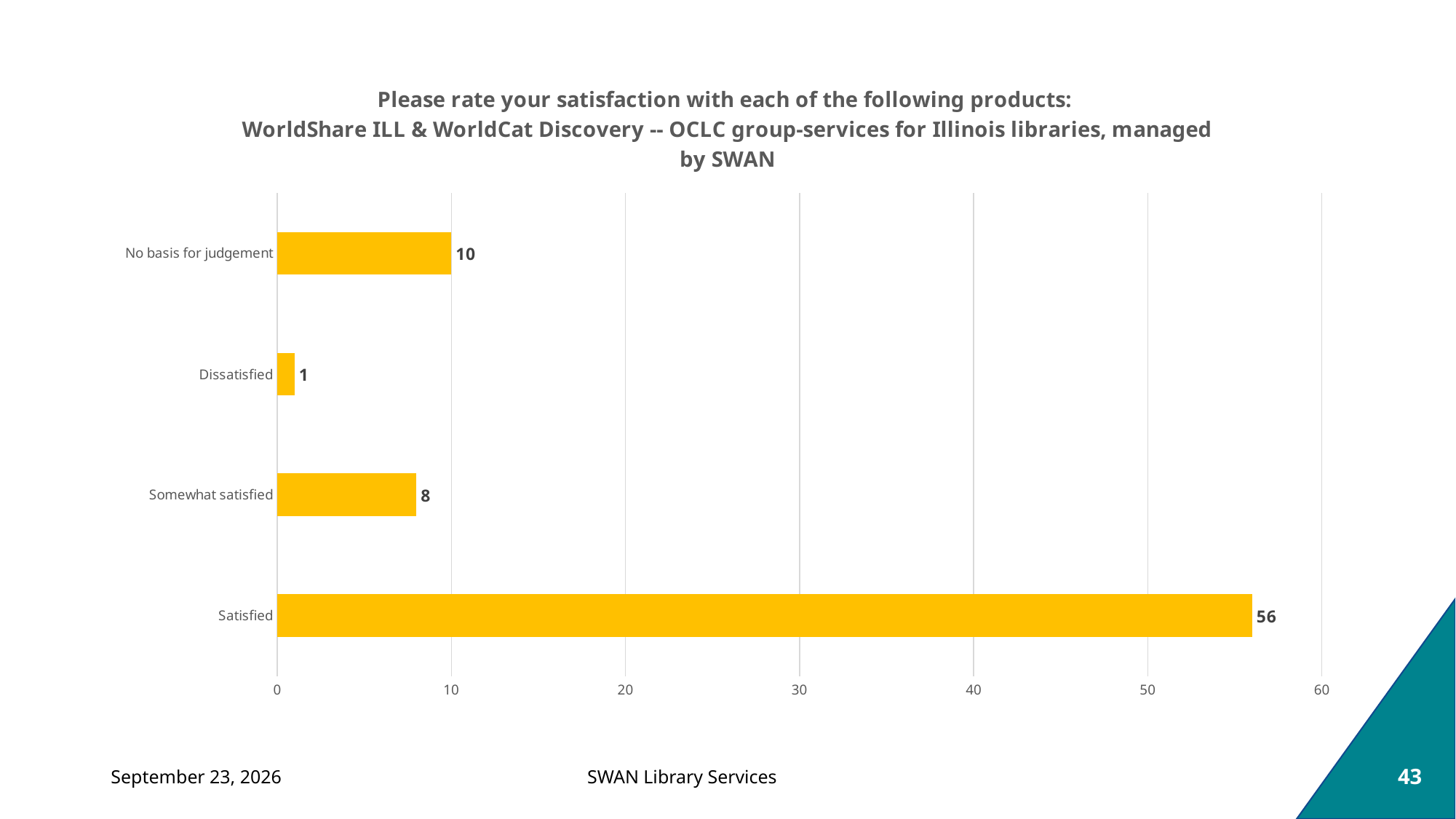
What is the value for Somewhat satisfied? 8 What is the value for No basis for judgement? 10 What is the difference between the values for No basis for judgement and Dissatisfied? 9 Which is larger, the value for No basis for judgement or the value for Somewhat satisfied? No basis for judgement Which category has the highest value? Satisfied What is the difference between the values for Satisfied and Somewhat satisfied? 48 Is the value for Satisfied greater or less than 50? greater What kind of chart is shown on the slide? Bar chart What is the value for Satisfied? 56 How many categories are shown in the chart? 4 What is the value for Dissatisfied? 1 Which category has the lowest value? Dissatisfied